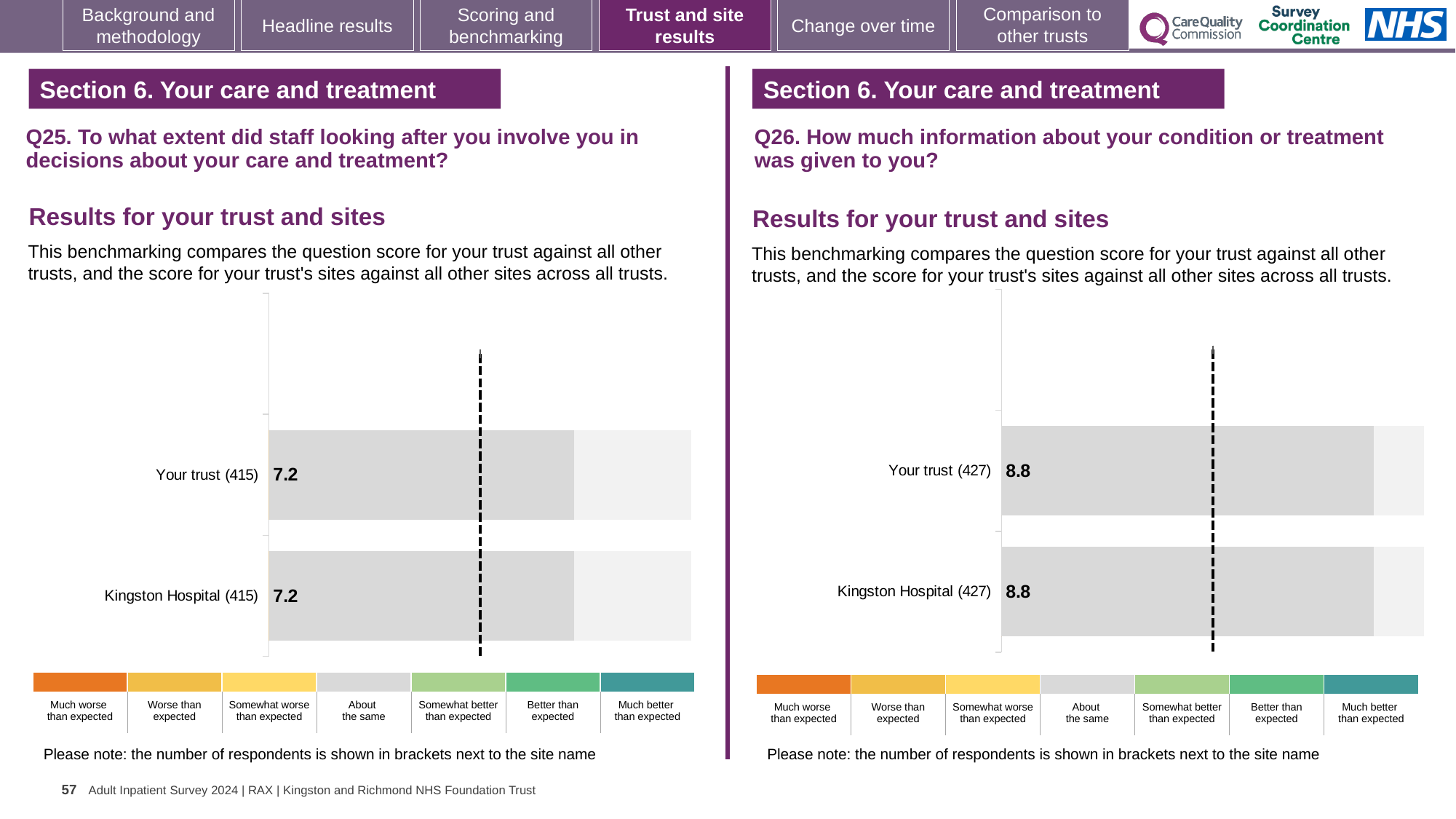
How many bars are plotted on the Q25 chart (left)? 2 On the Q26 chart (right), how many respondents are shown in brackets for Kingston Hospital? 427 What type of chart is used on the Q26 chart (right)? Bar chart On the Q25 chart (left), what is the score for Kingston Hospital? 7.2 How many bars are plotted on the Q26 chart (right)? 2 On the Q25 chart (left), how many respondents are shown in brackets for Your trust? 415 On the Q26 chart (right), what is the score for Kingston Hospital? 8.8 Is the score for Your trust on the Q26 chart (right) larger or smaller than the score for Your trust on the Q25 chart (left)? Larger On the Q25 chart (left), what is the difference between the scores for Your trust and Kingston Hospital? 0 On the Q26 chart (right), what is the difference between the scores for Your trust and Kingston Hospital? 0 On the Q25 chart (left), what is the score for Your trust? 7.2 On the Q26 chart (right), what is the score for Your trust? 8.8